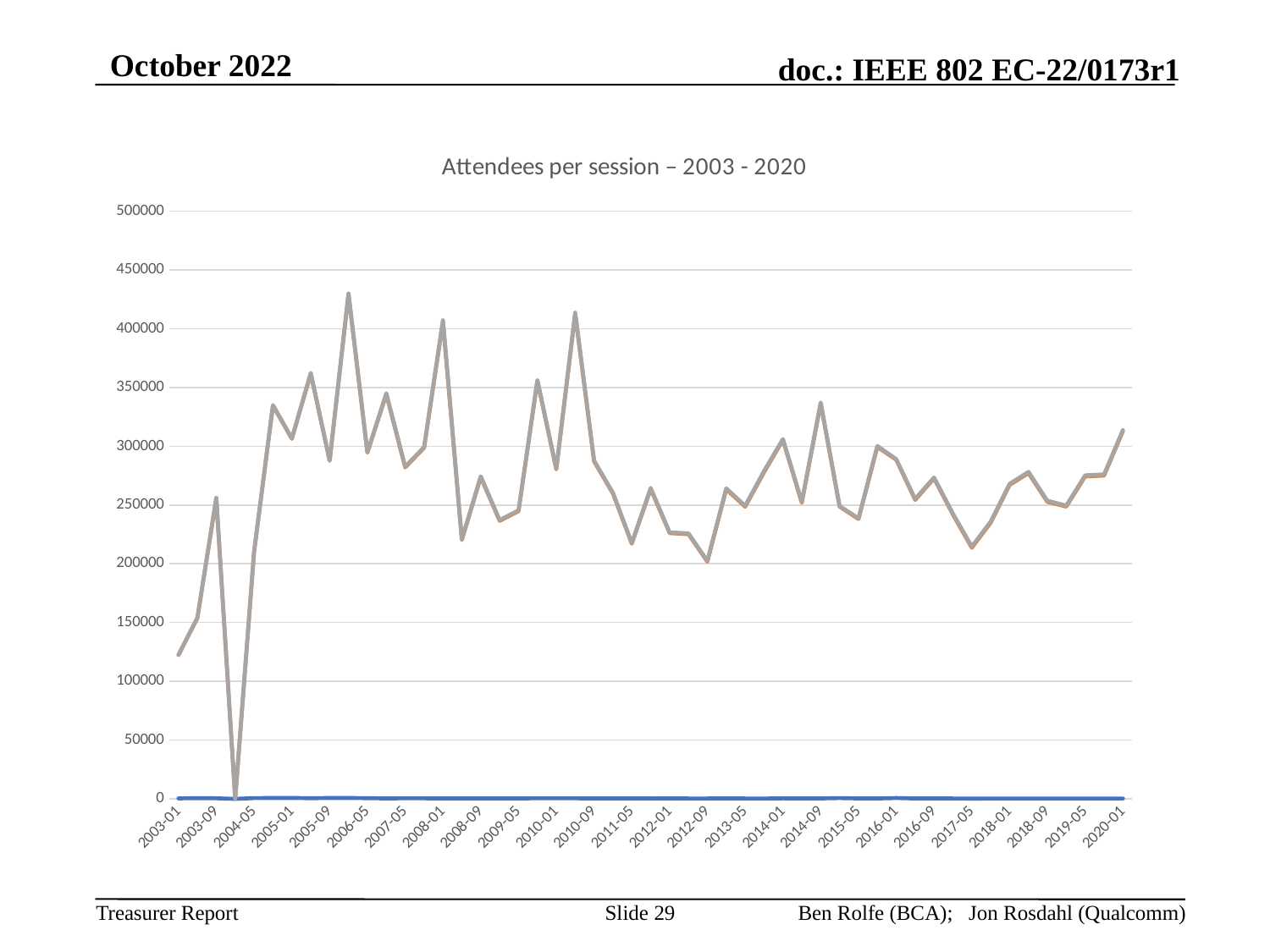
Which is larger, the value for 2008-01 or the value for 2011-05? 2008-01 Is the value for 2003-01 greater or less than 150000? less Which is larger, the value for 2003-01 or the value for 2020-01? 2020-01 Is the value for 2020-01 greater or less than 300000? greater Do the values rise or fall from 2003-01 to 2003-09? rise Is the value for 2014-09 greater or less than 300000? greater What is the title of the chart? Attendees per session – 2003 - 2020 What kind of chart is shown on the slide? line chart What is the highest value shown on the y axis? 500000